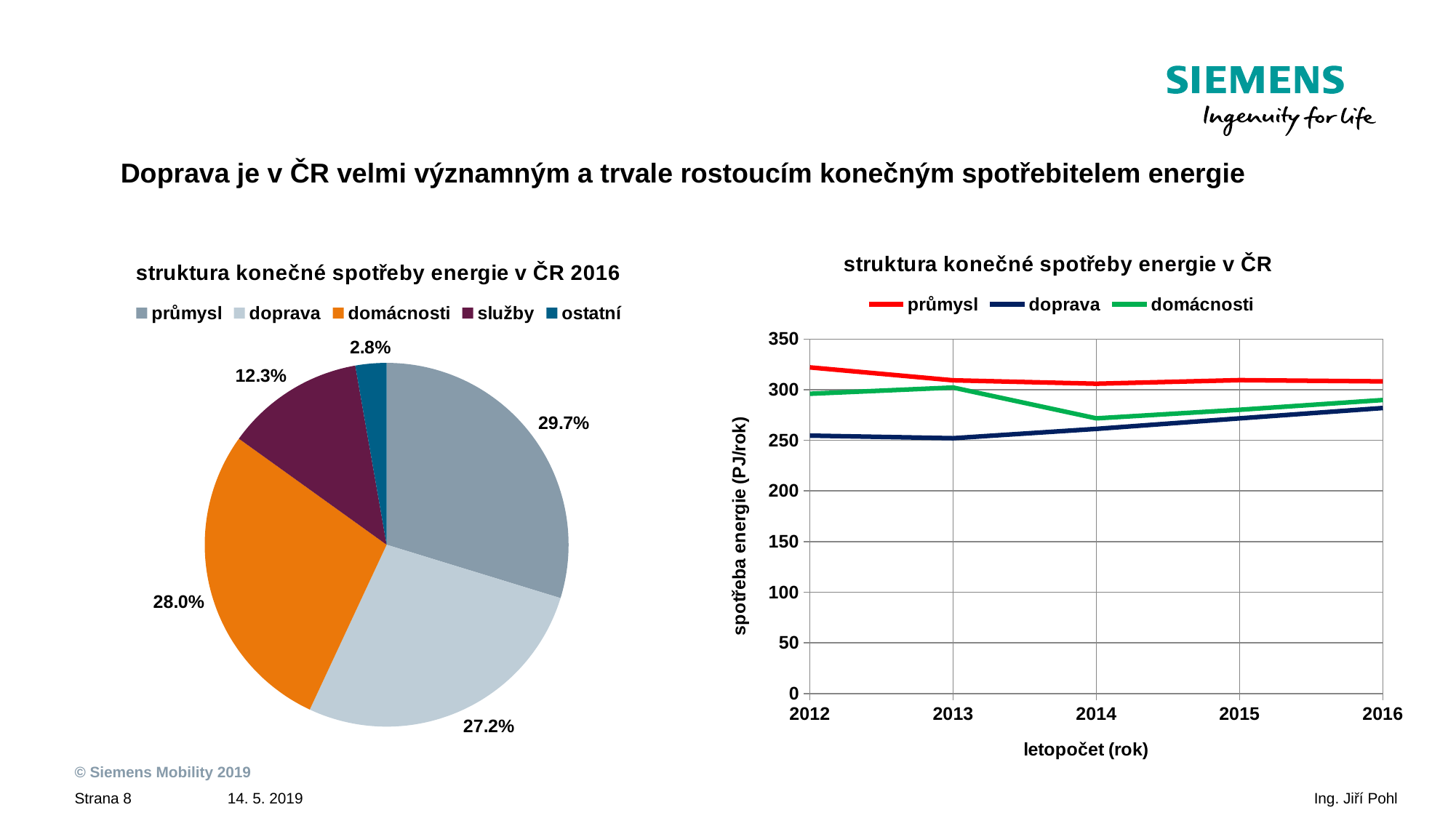
In the line chart 'struktura konečné spotřeby energie v ČR', is the value for doprava in 2012 greater or less than 300? less In the line chart 'struktura konečné spotřeby energie v ČR', does the doprava series rise or fall between 2013 and 2016? rise In the pie chart 'struktura konečné spotřeby energie v ČR 2016', what share does služby have? 12.3% In the pie chart 'struktura konečné spotřeby energie v ČR 2016', what share does doprava have? 27.2% In the pie chart 'struktura konečné spotřeby energie v ČR 2016', which is larger, domácnosti or doprava? domácnosti In the pie chart 'struktura konečné spotřeby energie v ČR 2016', which category has the largest share? průmysl In the pie chart 'struktura konečné spotřeby energie v ČR 2016', what is the difference between the shares of průmysl and doprava? 2.5% In the pie chart 'struktura konečné spotřeby energie v ČR 2016', which category has the smallest share? ostatní In the line chart 'struktura konečné spotřeby energie v ČR', is the value for průmysl in 2012 greater or less than 300? greater What kind of chart is the chart on the right side of the slide, 'struktura konečné spotřeby energie v ČR'? line chart How many series does the legend of the line chart 'struktura konečné spotřeby energie v ČR' list? 3 How many categories does the pie chart 'struktura konečné spotřeby energie v ČR 2016' show? 5